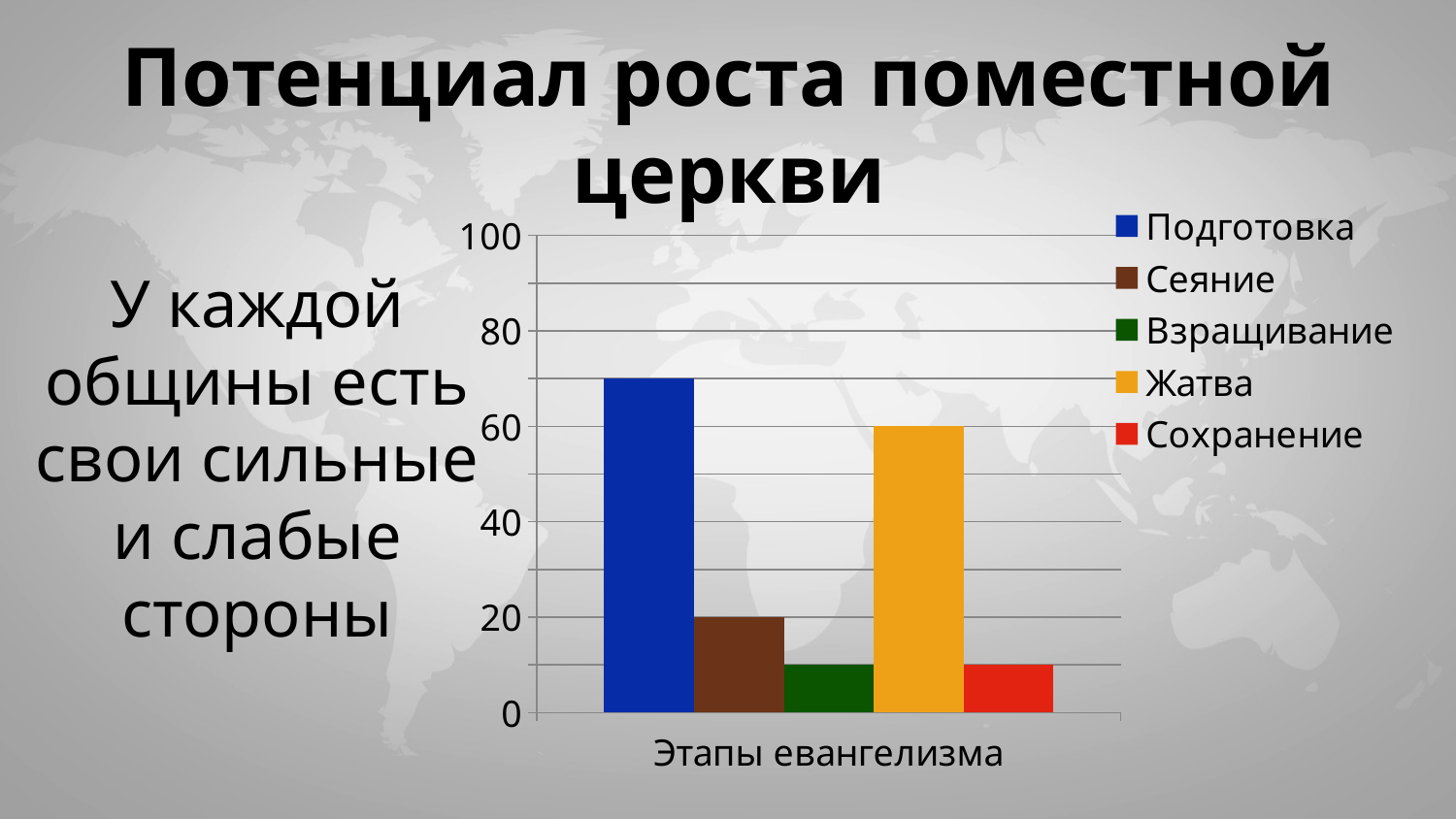
Is the value for Подготовка greater or less than 60? greater Which is larger, the value for Подготовка or the value for Жатва? Подготовка What is the value for Жатва? 60 What is the difference between the values for Жатва and Сеяние? 40 What is the label on the x axis of the chart? Этапы евангелизма What is the value for Сеяние? 20 Is the value for Взращивание greater or less than 20? less How many series does the legend list? 5 Is the value for Сохранение greater or less than 20? less How many categories are shown on the x axis? 1 What kind of chart is shown on the slide? bar chart Which series has the highest bar? Подготовка